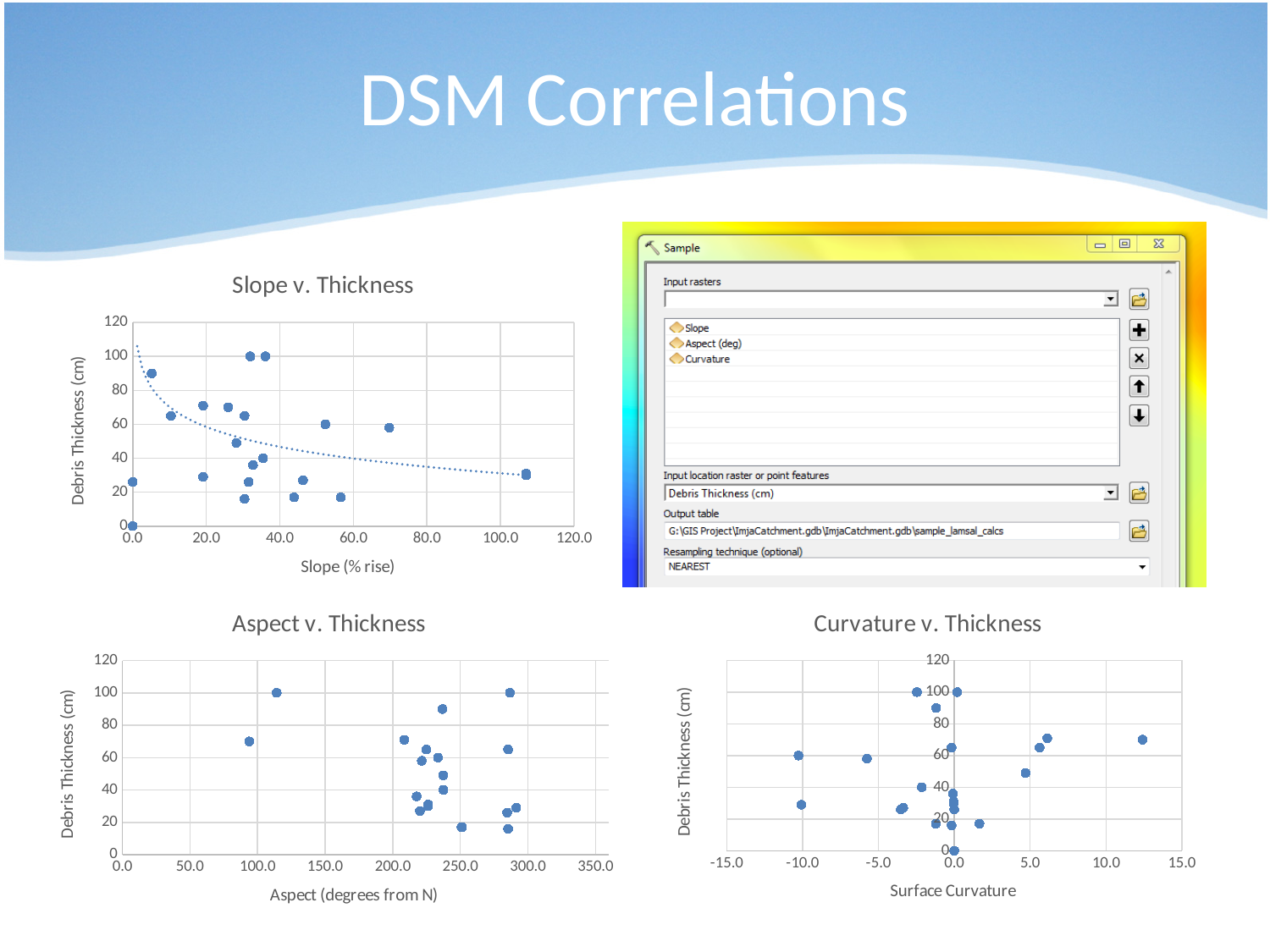
In the "Slope v. Thickness" chart, does the dotted trend line rise or fall as slope increases? falls In the "Aspect v. Thickness" chart, is the highest plotted debris thickness greater or less than 80? greater In the "Slope v. Thickness" chart, is the debris thickness of the point with the largest slope greater or less than 40? less What is the maximum value shown on the y-axis of the "Curvature v. Thickness" chart? 120 What is the x-axis title of the "Slope v. Thickness" chart? Slope (% rise) In the "Curvature v. Thickness" chart, is the debris thickness of the point with the largest surface curvature greater or less than 60? greater How many charts are shown on the slide? 3 In the "Slope v. Thickness" chart, what is the lowest debris thickness plotted? 0 What kind of chart is "Curvature v. Thickness"? scatter chart What kind of chart is "Slope v. Thickness"? scatter chart